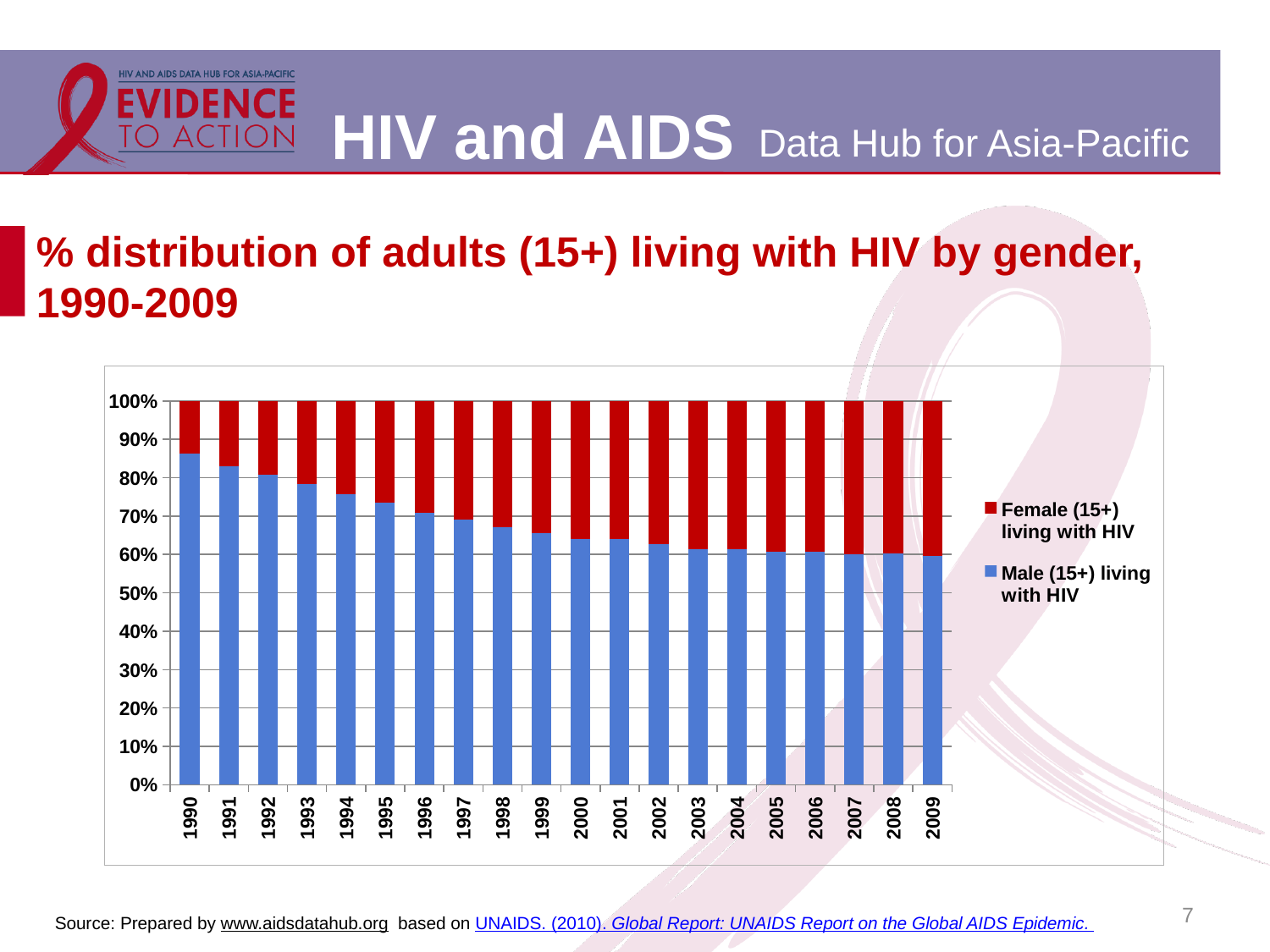
Is the share of Female (15+) living with HIV in 2009 greater or less than 30%? greater Is the share of Male (15+) living with HIV in 2000 greater or less than 70%? less Is the share of Female (15+) living with HIV in 1990 greater or less than 20%? less What are the two series named in the legend? Female (15+) living with HIV; Male (15+) living with HIV Does the share of Male (15+) living with HIV rise or fall from 1990 to 2009? fall How many years are shown on the x axis of the chart? 20 What type of chart is shown on the slide? stacked bar chart Which year has a larger share of Male (15+) living with HIV, 1990 or 2005? 1990 How many series does the chart's legend list? 2 Which colour represents Male (15+) living with HIV in the chart? blue In which year is the share of Male (15+) living with HIV the highest? 1990